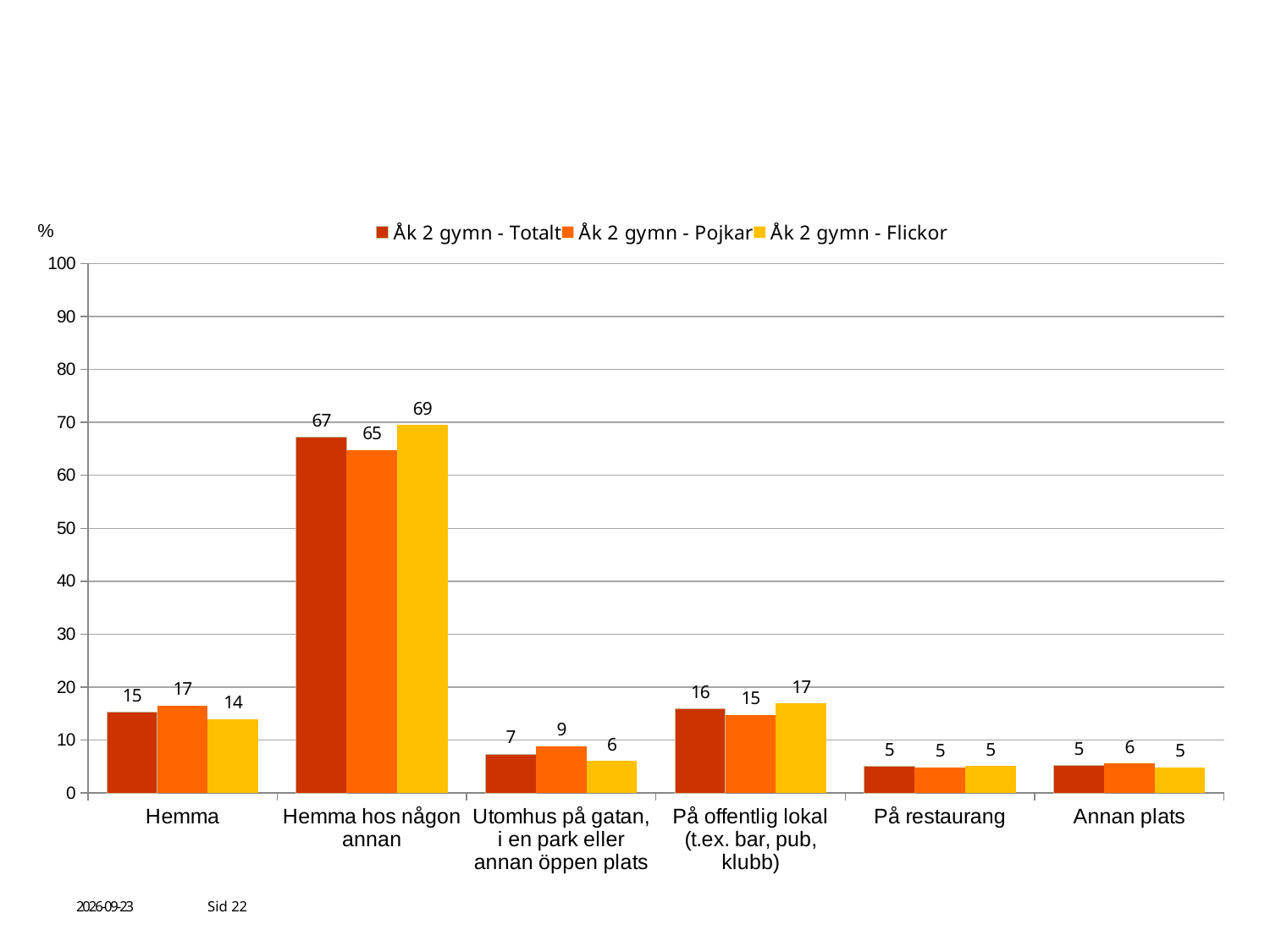
In the Utomhus på gatan, i en park eller annan öppen plats category, which is larger: Åk 2 gymn - Pojkar or Åk 2 gymn - Flickor? Åk 2 gymn - Pojkar Is the value for Åk 2 gymn - Totalt in the Hemma hos någon annan category greater or less than 50? greater Which category has the lowest value for Åk 2 gymn - Flickor? På restaurang and Annan plats (both 5) What unit is shown on the y axis label? % What kind of chart is shown on the slide? bar chart How many categories are shown on the x axis? 6 What is the difference between the Åk 2 gymn - Flickor and Åk 2 gymn - Pojkar values in the Hemma hos någon annan category? 4 What is the value for Åk 2 gymn - Pojkar in the Hemma category? 17 Which category has the highest value for Åk 2 gymn - Totalt? Hemma hos någon annan What is the value for Åk 2 gymn - Totalt in the På offentlig lokal (t.ex. bar, pub, klubb) category? 16 How many series does the legend list? 3 What is the value for Åk 2 gymn - Flickor in the Hemma hos någon annan category? 69